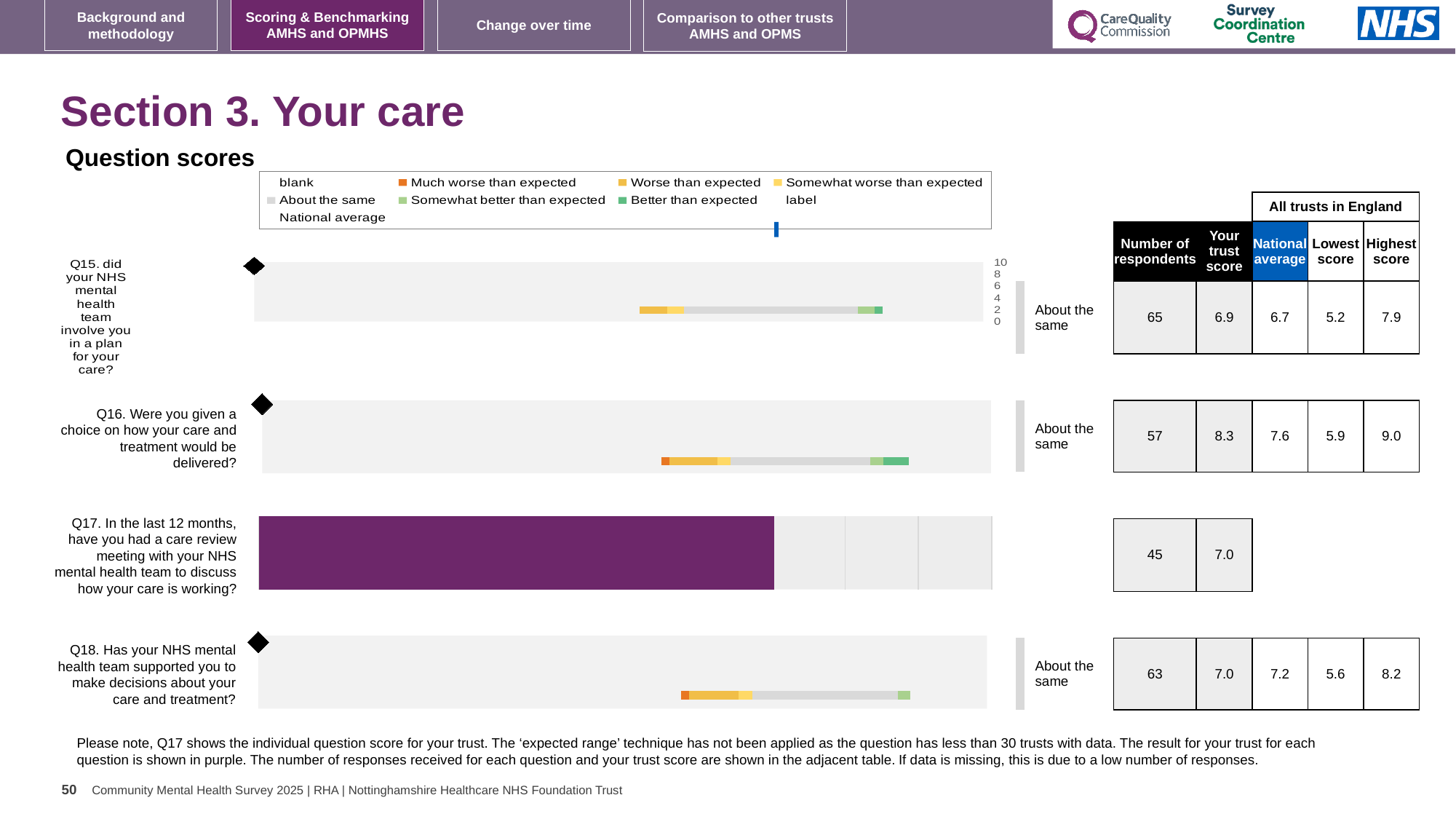
Which question has the lowest number of respondents? Q17 What is the national average for Q15 (did your NHS mental health team involve you in a plan for your care)? 6.7 What is the difference between the trust score and the national average for Q16? 0.7 What is the trust score for Q16 (Were you given a choice on how your care and treatment would be delivered)? 8.3 How many questions are plotted on this slide? 4 Which question has the highest trust score on this slide? Q16 For Q18, which is larger: the trust score or the national average? National average What is the lowest score among all trusts in England for Q15? 5.2 What benchmark category label is shown next to the Q15 chart? About the same How many respondents answered Q17? 45 What is the highest score among all trusts in England for Q18? 8.2 What kind of chart is used to show the question scores? Bar chart